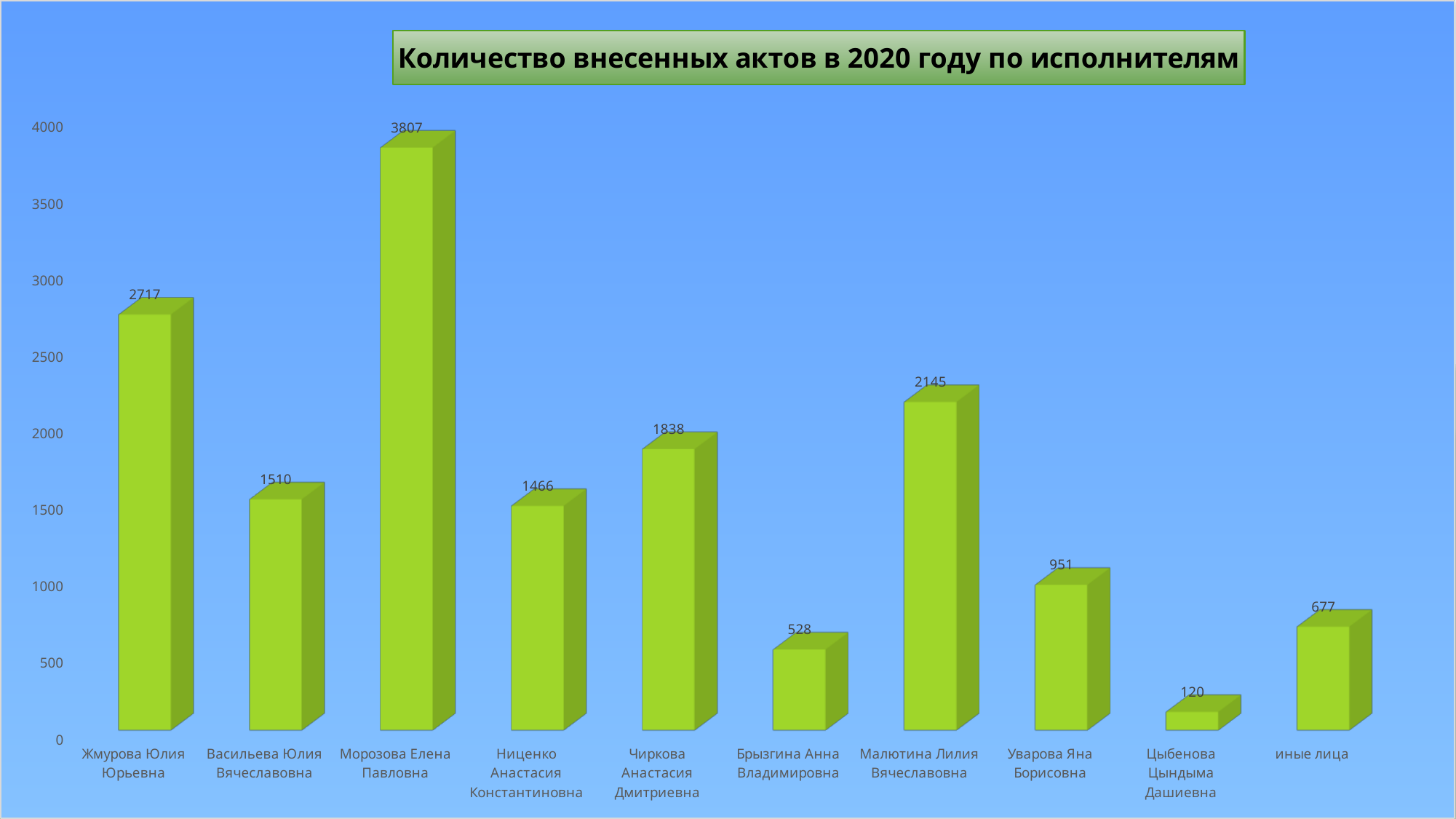
What is the value for Уварова Яна Борисовна? 951 Which category has the lowest value? Цыбенова Цындыма Дашиевна What kind of chart is this? bar chart What is the value for иные лица? 677 How many categories are shown on the x axis? 10 What is the difference between the values for Брызгина Анна Владимировна and Цыбенова Цындыма Дашиевна? 408 Is the value for Ниценко Анастасия Константиновна greater or less than 1500? less What is the difference between the values for Жмурова Юлия Юрьевна and Васильева Юлия Вячеславовна? 1207 Which category has the highest value? Морозова Елена Павловна What is the title of the chart? Количество внесенных актов в 2020 году по исполнителям Which is larger, the value for Чиркова Анастасия Дмитриевна or the value for Малютина Лилия Вячеславовна? Малютина Лилия Вячеславовна What is the value for Морозова Елена Павловна? 3807